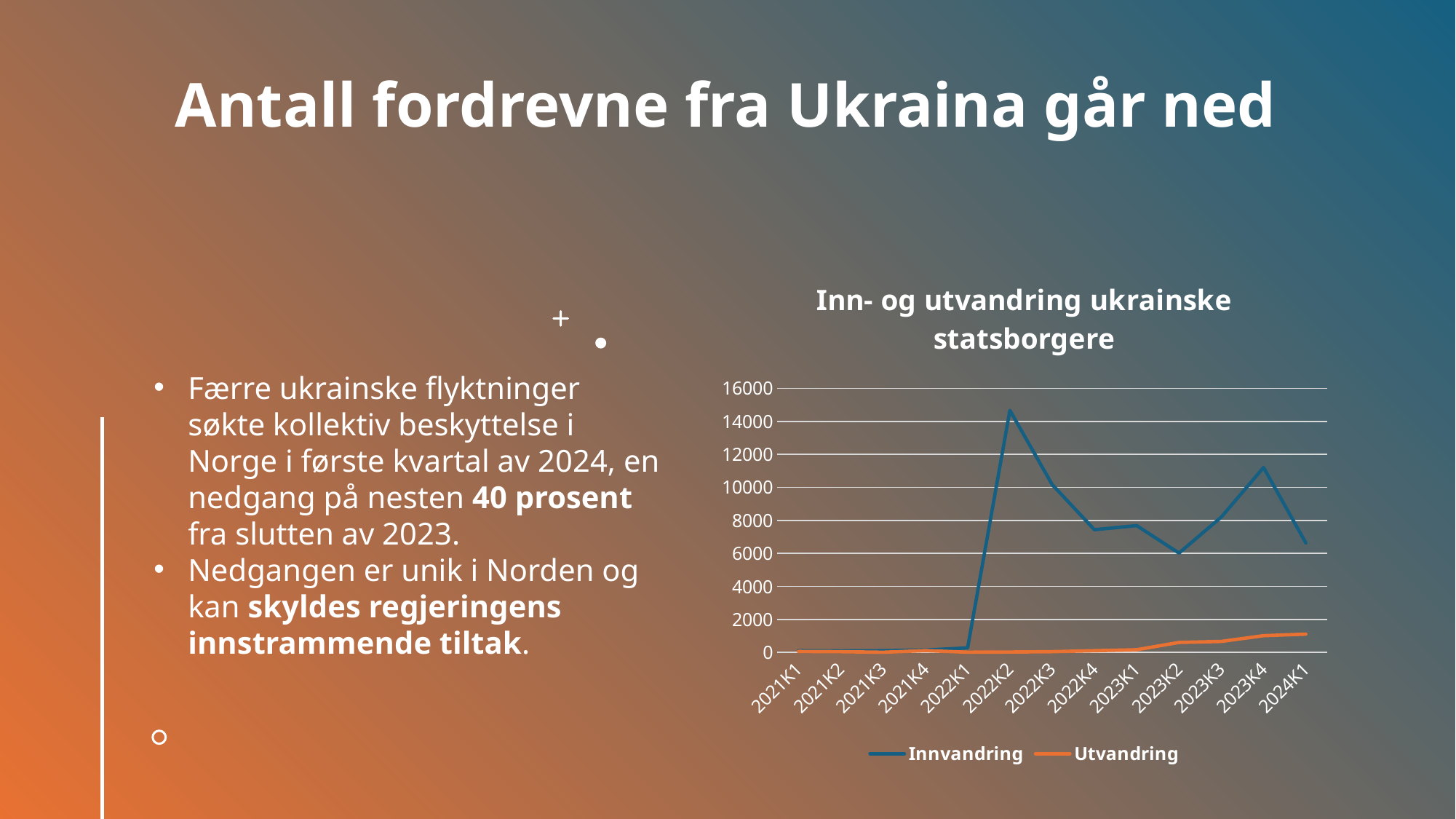
Is the Innvandring value for 2022K4 greater or less than 8000? less What kind of chart is shown on the slide? line chart Is the Utvandring value for 2024K1 greater or less than 2000? less Which series has the larger value in 2022K2, Innvandring or Utvandring? Innvandring Does the Innvandring series rise or fall from 2023K4 to 2024K1? fall Which series is drawn in orange in the chart? Utvandring In which quarter does the Innvandring series reach its highest value? 2022K2 How many quarters are plotted along the x axis of the chart? 13 What is the title of the chart? Inn- og utvandring ukrainske statsborgere Is the Innvandring value for 2022K2 greater or less than 14000? greater How many series does the legend of the chart list? 2